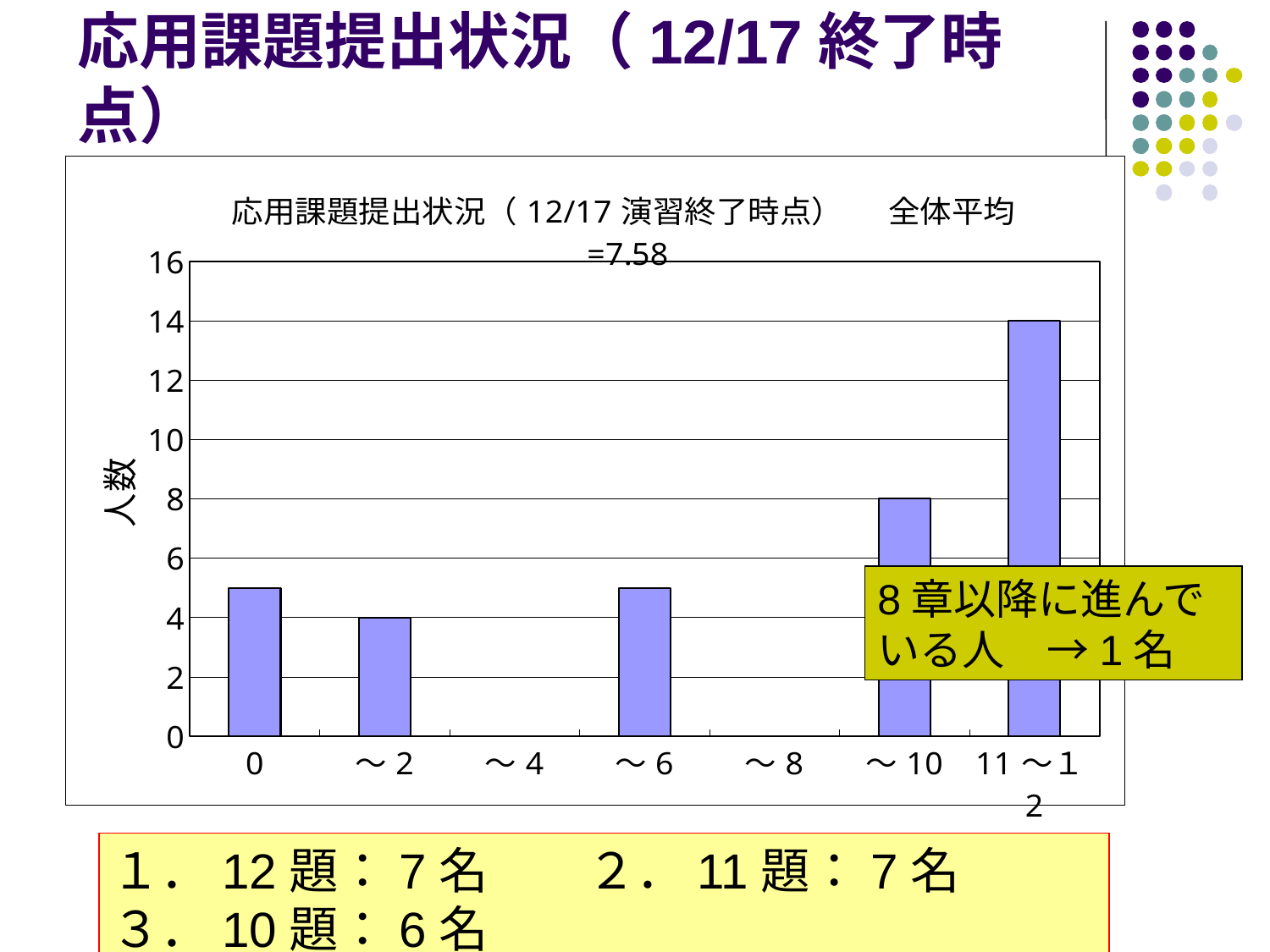
Which is larger, the value for ～10 or the value for ～2? ～10 What is the difference between the values for ～10 and ～2? 4 What is the value for the ～2 category? 4 What is the label on the y axis of the chart? 人数 Which category has the highest value in the chart? 11～12 How many categories are shown on the x axis of the chart? 7 What kind of chart is shown on the slide? bar chart What is the difference between the values for 11～12 and ～10? 6 What is the value for the ～10 category? 8 Is the value for the 0 category greater or less than 4? greater Is the value for the ～6 category greater or less than 6? less What is the value for the 11～12 category? 14